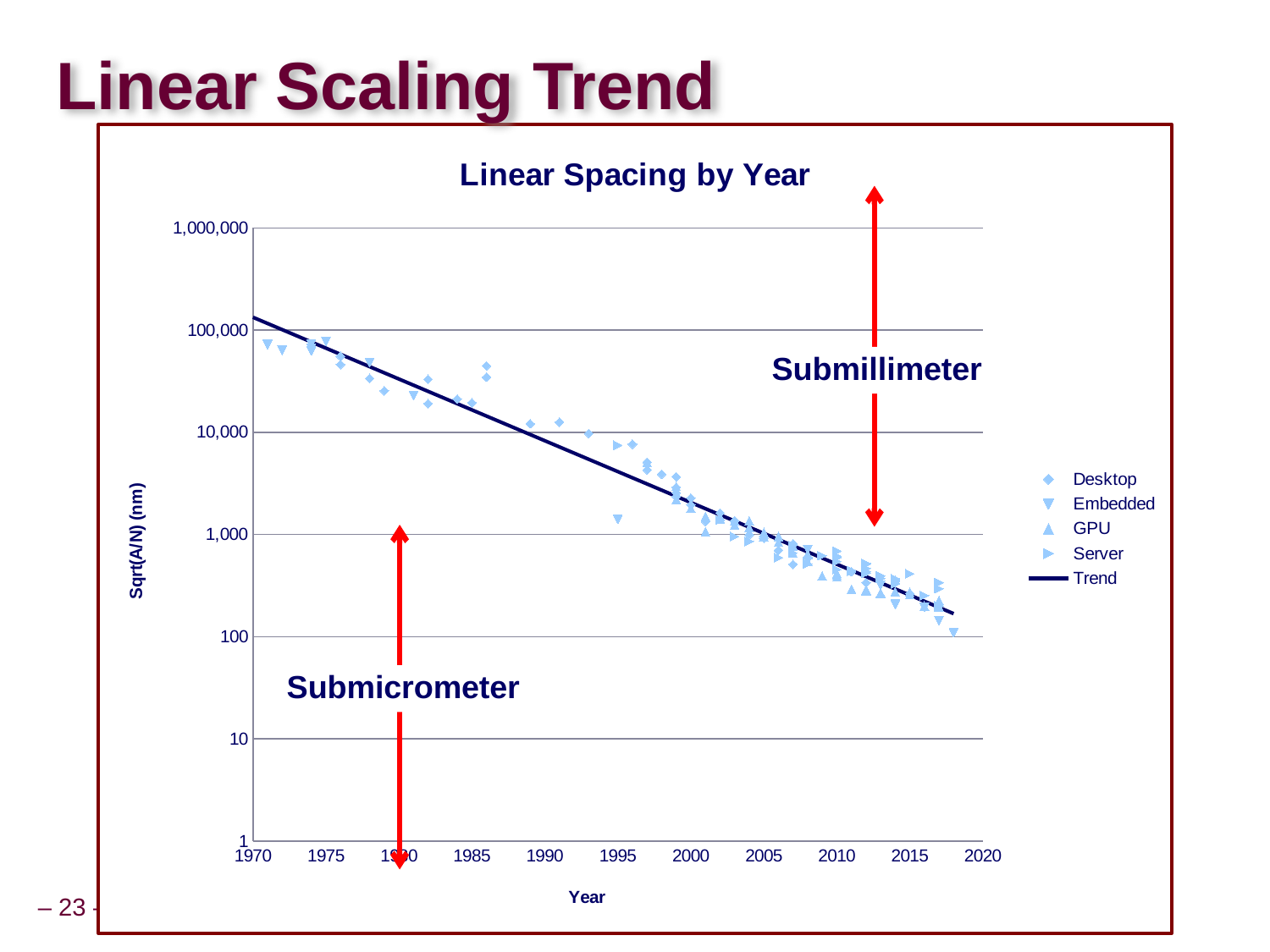
What is the first year shown on the x axis? 1970 Do the plotted values rise or fall as the year increases along the x axis? fall Are the Embedded values plotted around 1972 greater or less than 10,000? greater What is the title of the chart? Linear Spacing by Year Are the Server values plotted around 1996 greater or less than 1,000? greater Are the values plotted around 2015 greater or less than 1,000? less What kind of chart is shown on the slide? scatter chart What is the label of the y axis? Sqrt(A/N) (nm) How many entries does the chart's legend list? 5 Which is larger: the Desktop values plotted around 1975 or the Desktop values plotted around 2010? around 1975